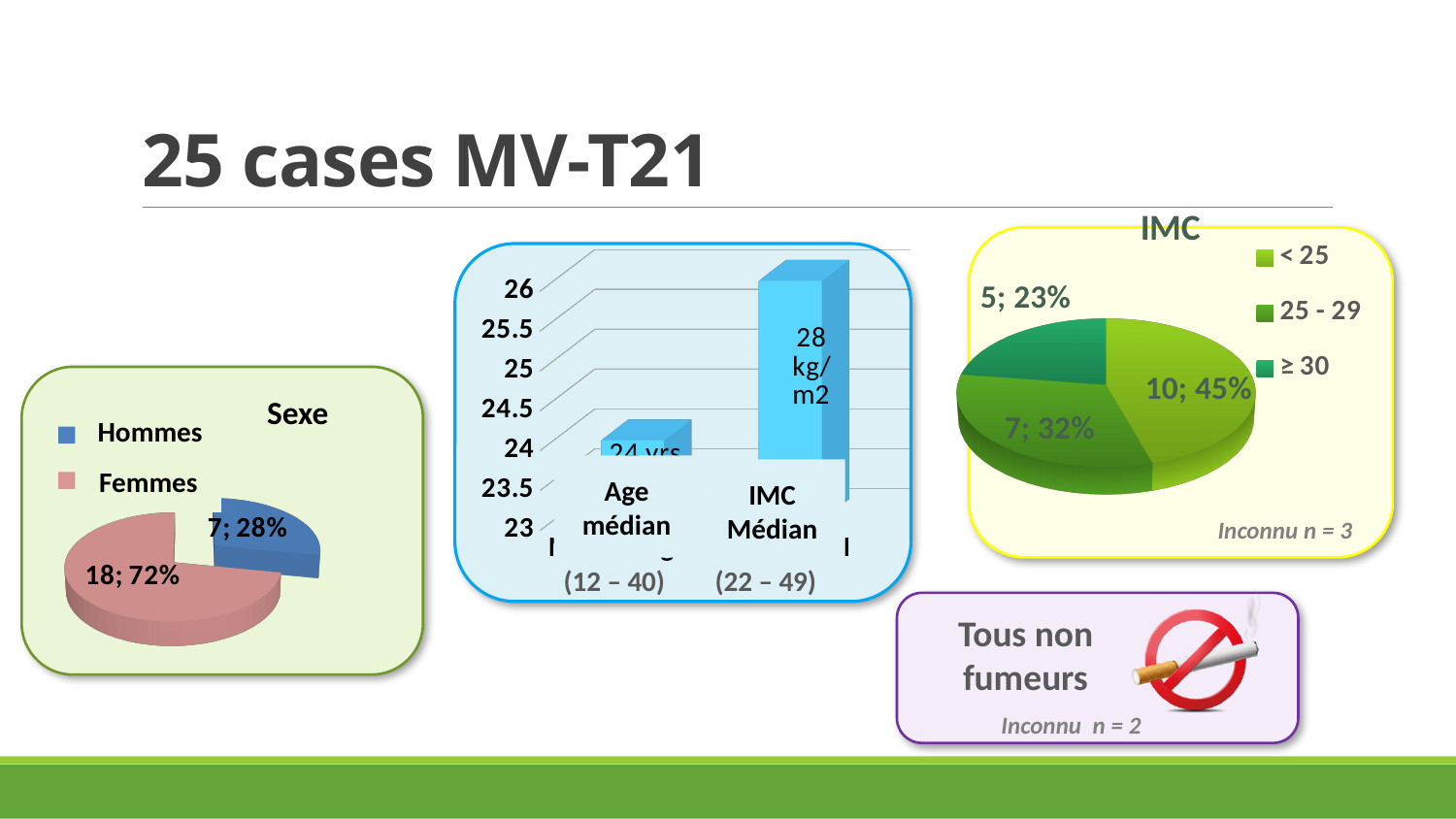
In the Sexe pie chart, what is the value shown for Hommes? 7; 28% What kind of chart is the Sexe chart? Pie chart In the IMC pie chart, what is the value shown for the ≥ 30 category? 5; 23% In the Sexe pie chart, what is the value shown for Femmes? 18; 72% In the IMC pie chart, which category has the smallest slice? ≥ 30 In the middle bar chart, which bar is taller, Age médian or IMC Médian? IMC Médian In the IMC pie chart, what is the value shown for the < 25 category? 10; 45% In the Sexe pie chart, what share of the pie do Femmes represent? 72% In the middle bar chart, what data label is shown on the IMC Médian bar? 28 kg/m2 In the Sexe pie chart, which category has the larger slice? Femmes In the Sexe pie chart, how many more Femmes than Hommes are there? 11 How many categories does the IMC pie chart legend list? 3